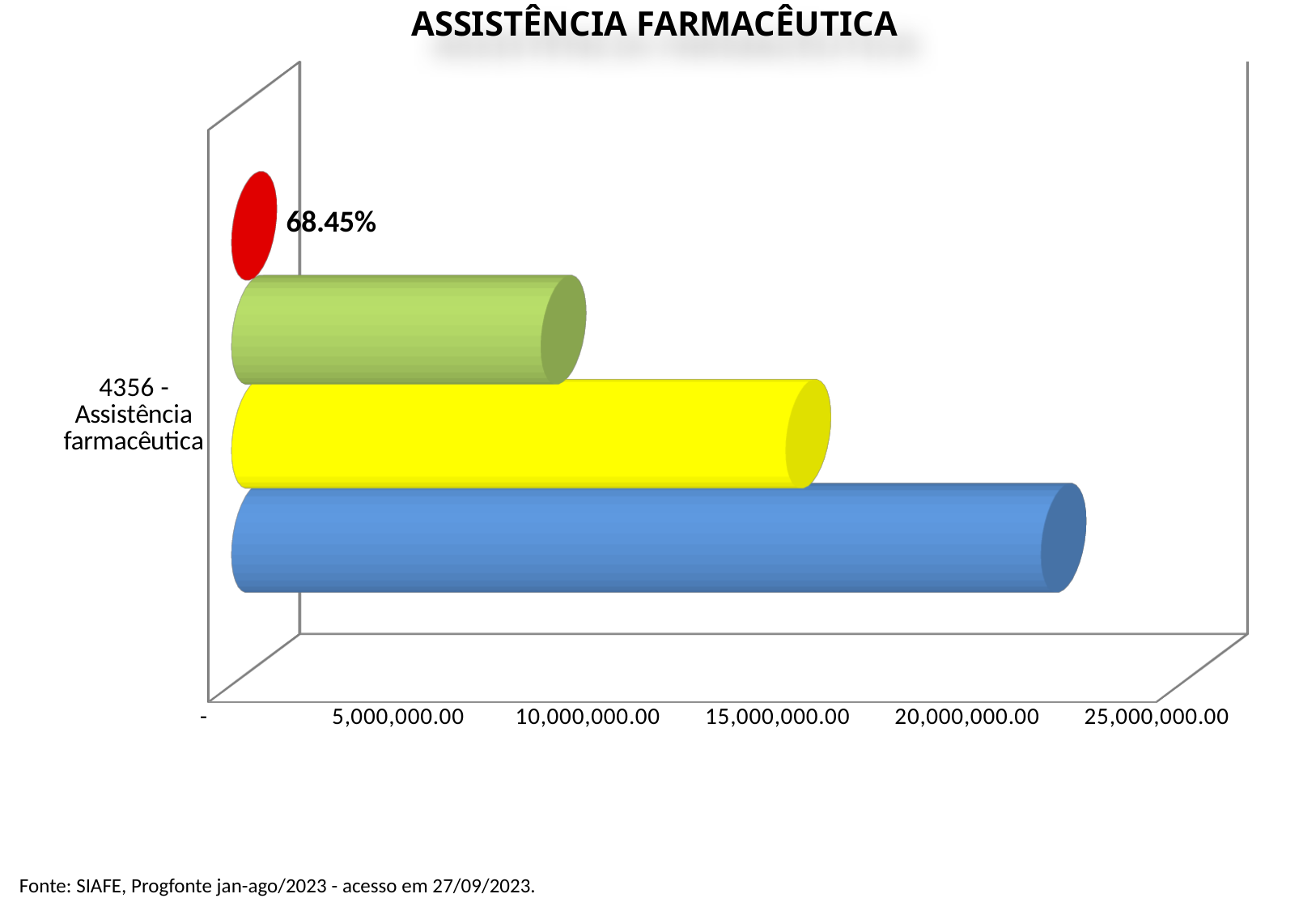
Is the value of the blue bar greater or less than 20,000,000.00? greater Which is larger, the yellow bar or the green bar? yellow How many bars are plotted for the category 4356 - Assistência farmacêutica? 3 How many categories are shown on the vertical axis of the chart? 1 What kind of chart is shown on the slide? bar chart What is the title of the chart? ASSISTÊNCIA FARMACÊUTICA Which coloured bar is the longest in the chart? blue Which coloured bar is the shortest in the chart? green Is the value of the yellow bar greater or less than 10,000,000.00? greater What percentage is printed next to the red circle on the chart? 68.45% Is the value of the green bar greater or less than 10,000,000.00? less What is the category label shown on the vertical axis? 4356 - Assistência farmacêutica